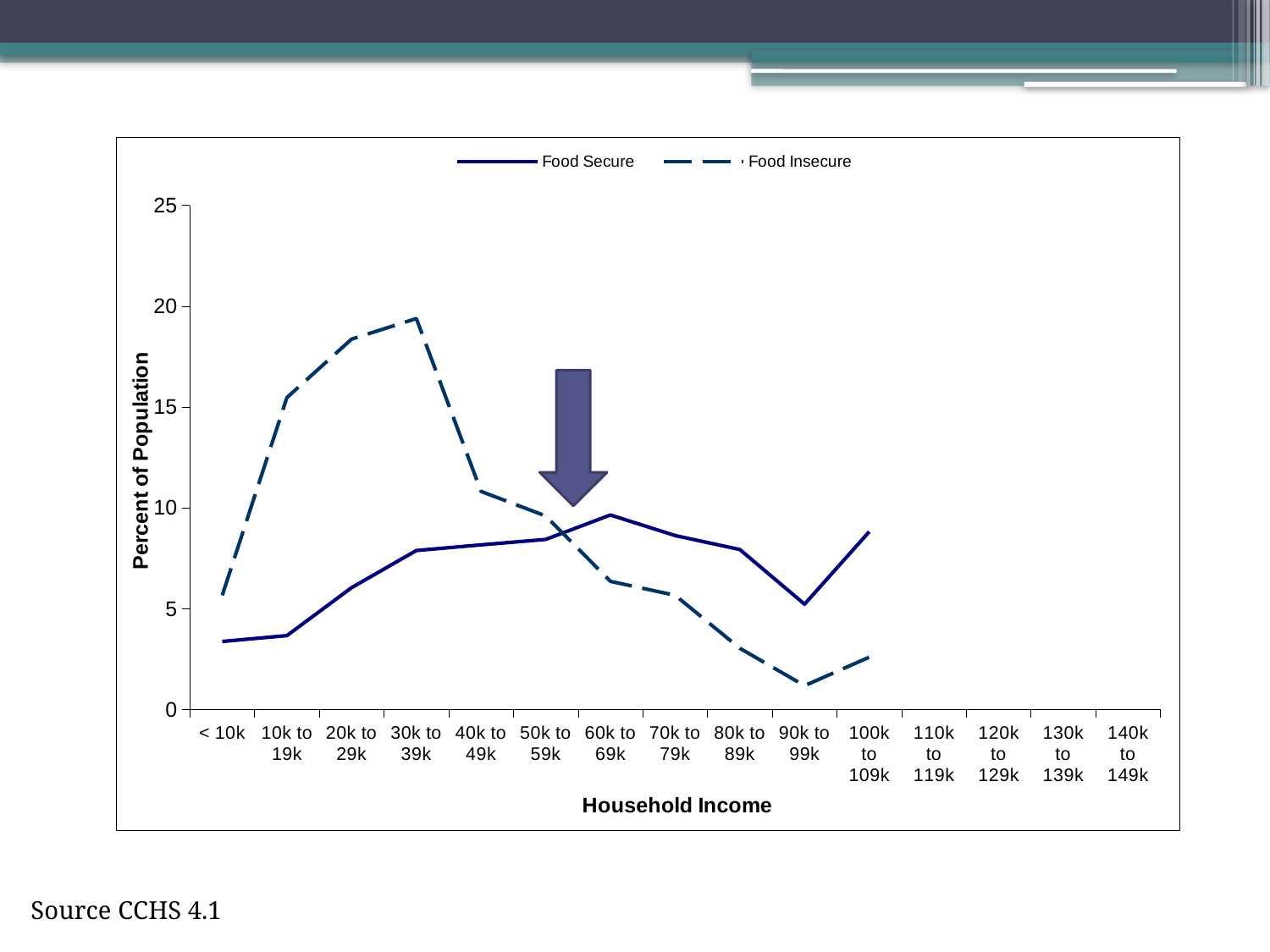
In which household income category does the Food Insecure series reach its highest value? 30k to 39k What are the two series named in the legend? Food Secure and Food Insecure At 10k to 19k, which series has the larger value, Food Secure or Food Insecure? Food Insecure In which household income category does the Food Insecure series reach its lowest value? 90k to 99k Is the Food Insecure value for 30k to 39k greater or less than 15? greater How many series does the legend list? 2 What kind of chart is shown on the slide? line chart What is the title of the y axis? Percent of Population Does the Food Insecure series rise or fall between 30k to 39k and 90k to 99k? fall Is the Food Secure value for < 10k greater or less than 5? less How many household income categories are labelled on the x axis? 15 In which household income category does the Food Secure series reach its highest value? 60k to 69k